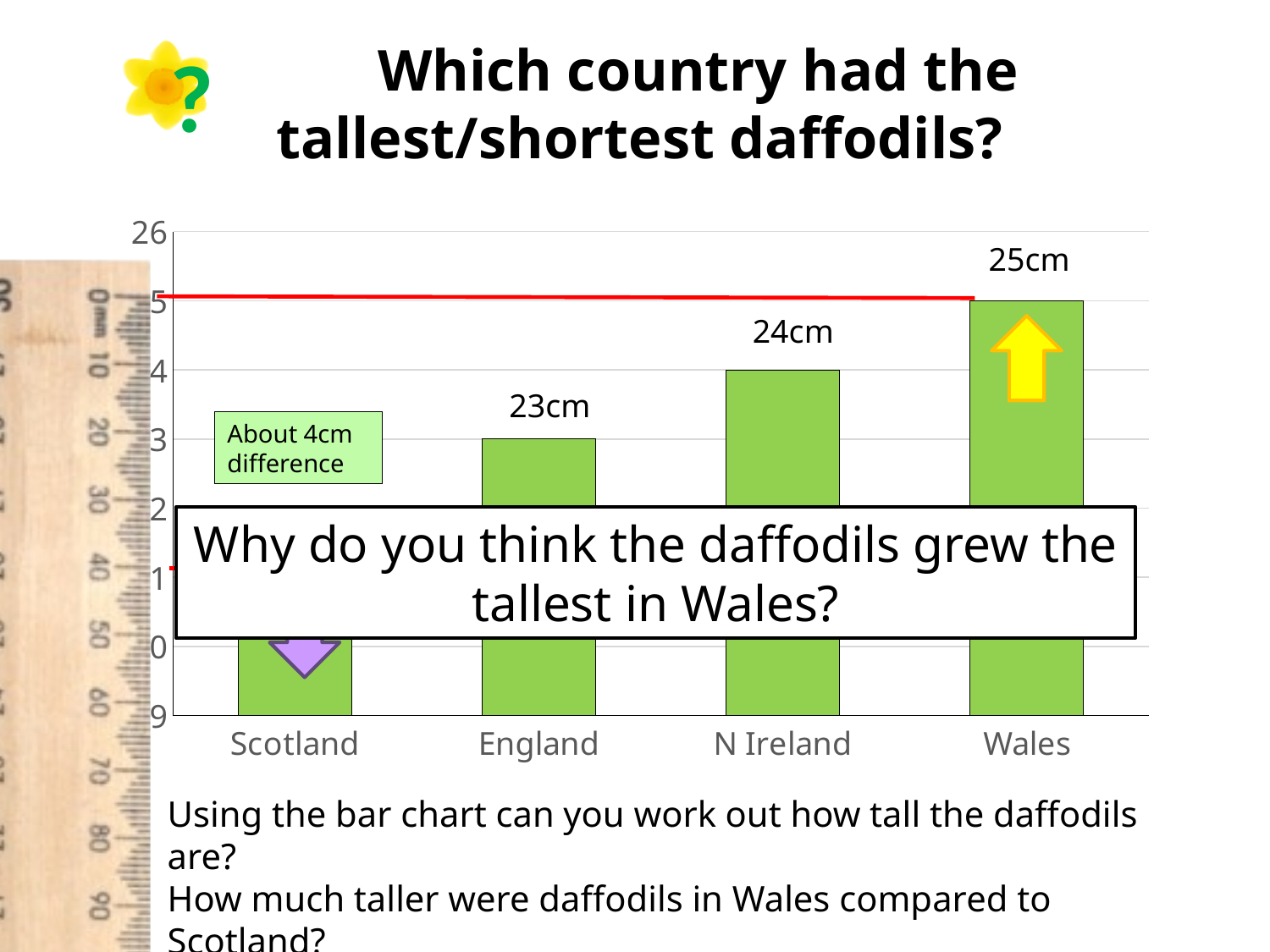
What kind of chart is shown on the slide? bar chart What is the daffodil height shown for Wales? 25cm Do the bar heights rise or fall from Scotland to Wales along the x axis? rise How much taller are the daffodils in Wales than in England? 2cm Which country has the tallest daffodils on the chart? Wales Which country has the shortest daffodils on the chart? Scotland What is the daffodil height shown for England? 23cm What is the difference between the daffodil heights for N Ireland and England? 1cm What is the daffodil height shown for N Ireland? 24cm Which is larger, the value for N Ireland or the value for Wales? Wales Is the value for Scotland greater or less than 23? less How many countries are shown on the bar chart? 4